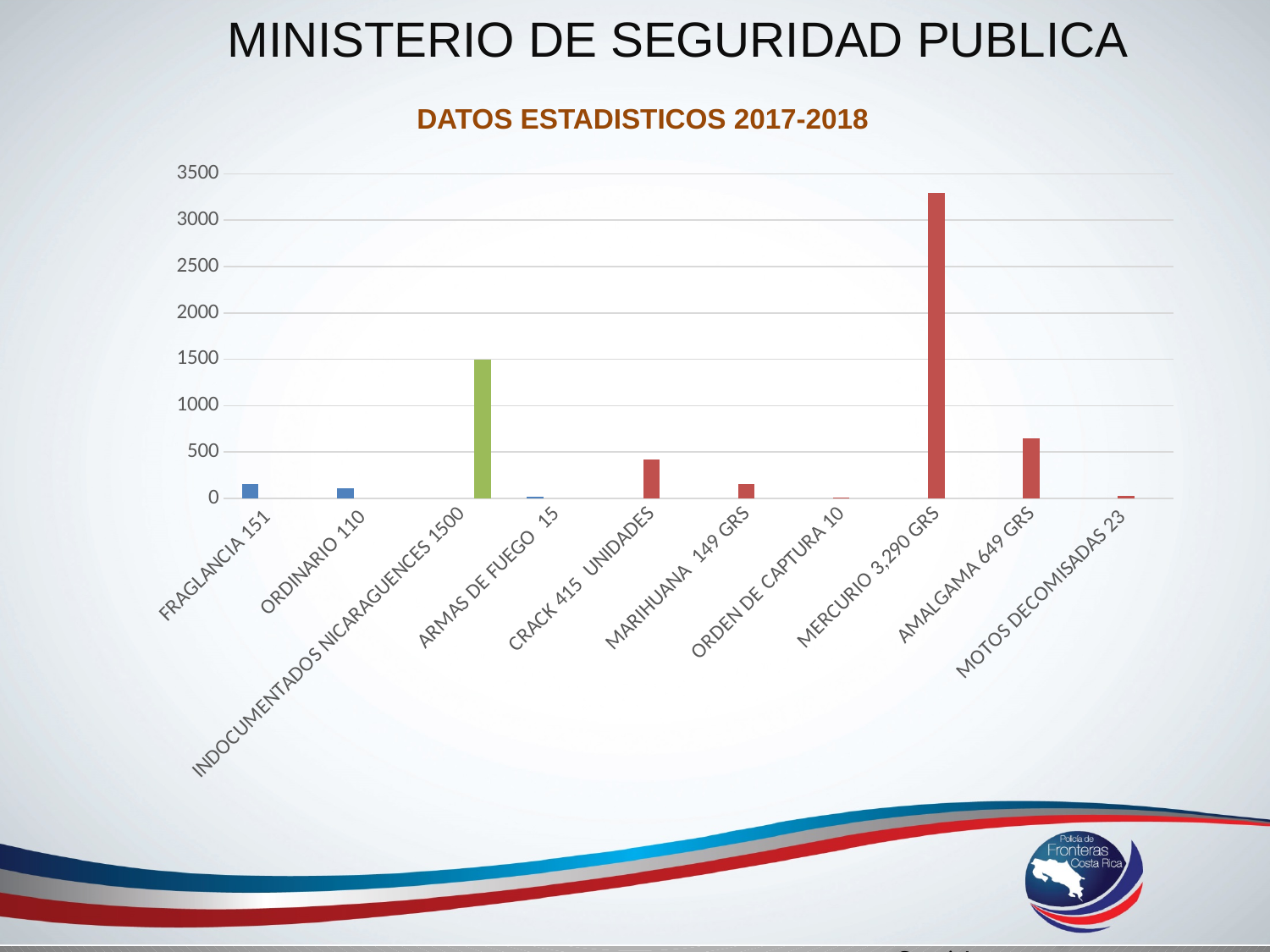
What value is shown for MOTOS DECOMISADAS? 23 What value is shown for INDOCUMENTADOS NICARAGUENCES? 1500 What is the title of the chart? DATOS ESTADISTICOS 2017-2018 Which category has the highest value in the chart? MERCURIO 3,290 GRS Which category has the lowest value in the chart? ORDEN DE CAPTURA 10 What type of chart is shown on the slide? bar chart Which is larger, the value for CRACK or the value for MARIHUANA? CRACK What is the difference between the value for FRAGLANCIA (151) and the value for ORDINARIO (110)? 41 What value is shown for AMALGAMA? 649 GRS How many categories are plotted in the chart? 10 Is the value for MERCURIO greater or less than 3000? greater Which bar in the chart is coloured green? INDOCUMENTADOS NICARAGUENCES 1500